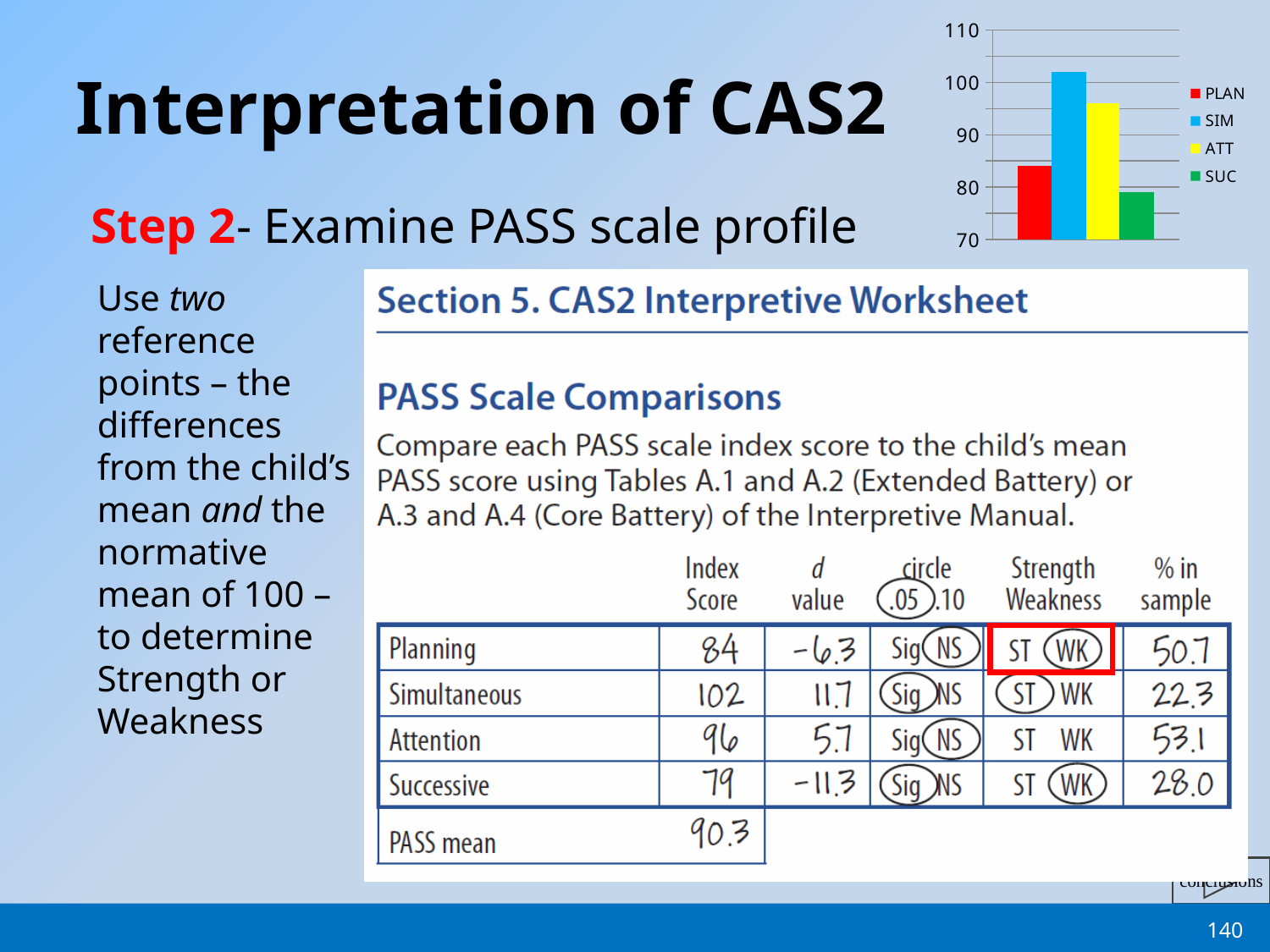
What colour is the SIM bar in the chart? blue Which series has the shortest bar in the chart? SUC Which is larger in the chart, the bar for SIM or the bar for SUC? SIM Which is larger in the chart, the bar for PLAN or the bar for ATT? ATT Is the value for SIM greater or less than 100? greater What kind of chart is shown in the top right of the slide? bar chart Which series has the tallest bar in the chart? SIM Is the value for SUC greater or less than 90? less How many series does the legend of the bar chart list? 4 What are the lowest and highest values shown on the chart's vertical axis? 70 and 110 Is the value for ATT greater or less than 90? greater